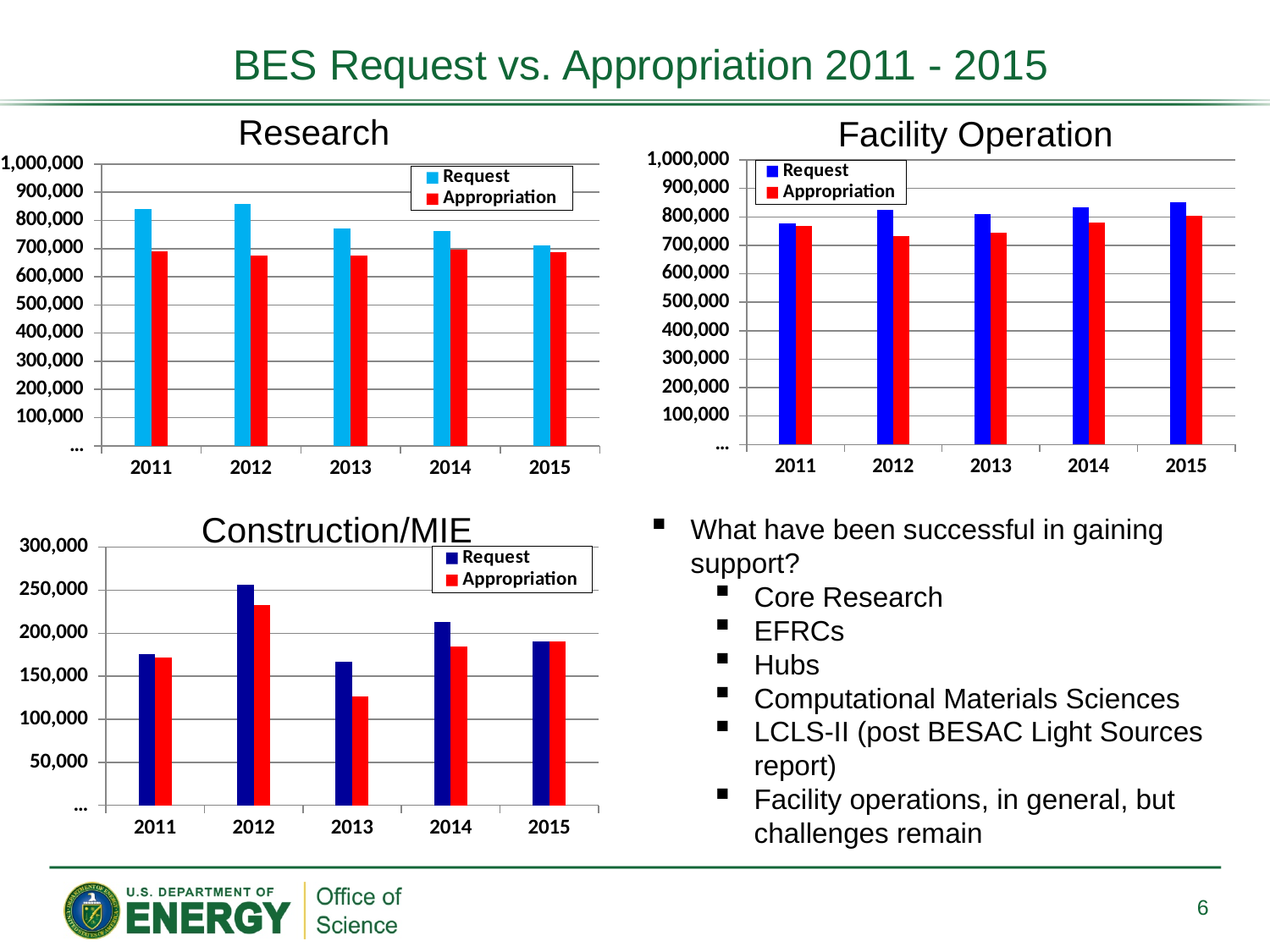
In the Research chart, how many series does the legend list? 2 In the Facility Operation chart, how many years are shown on the x axis? 5 In the Research chart, is the Appropriation value for 2012 greater or less than 700,000? less In the Construction/MIE chart, which year has the highest Request value? 2012 In the Research chart, what kind of chart is used? Bar chart How many charts are on the slide? 3 In the Facility Operation chart, do the Request values generally rise or fall from 2011 to 2015? rise In the Research chart, which year has the lowest Request value? 2015 In the Facility Operation chart, which year has the lowest Request value? 2011 In the Research chart, is the Request value for 2011 greater or less than 800,000? greater In the Facility Operation chart, which year has the highest Request value? 2015 In the Construction/MIE chart, is the Appropriation value for 2013 greater or less than 150,000? less